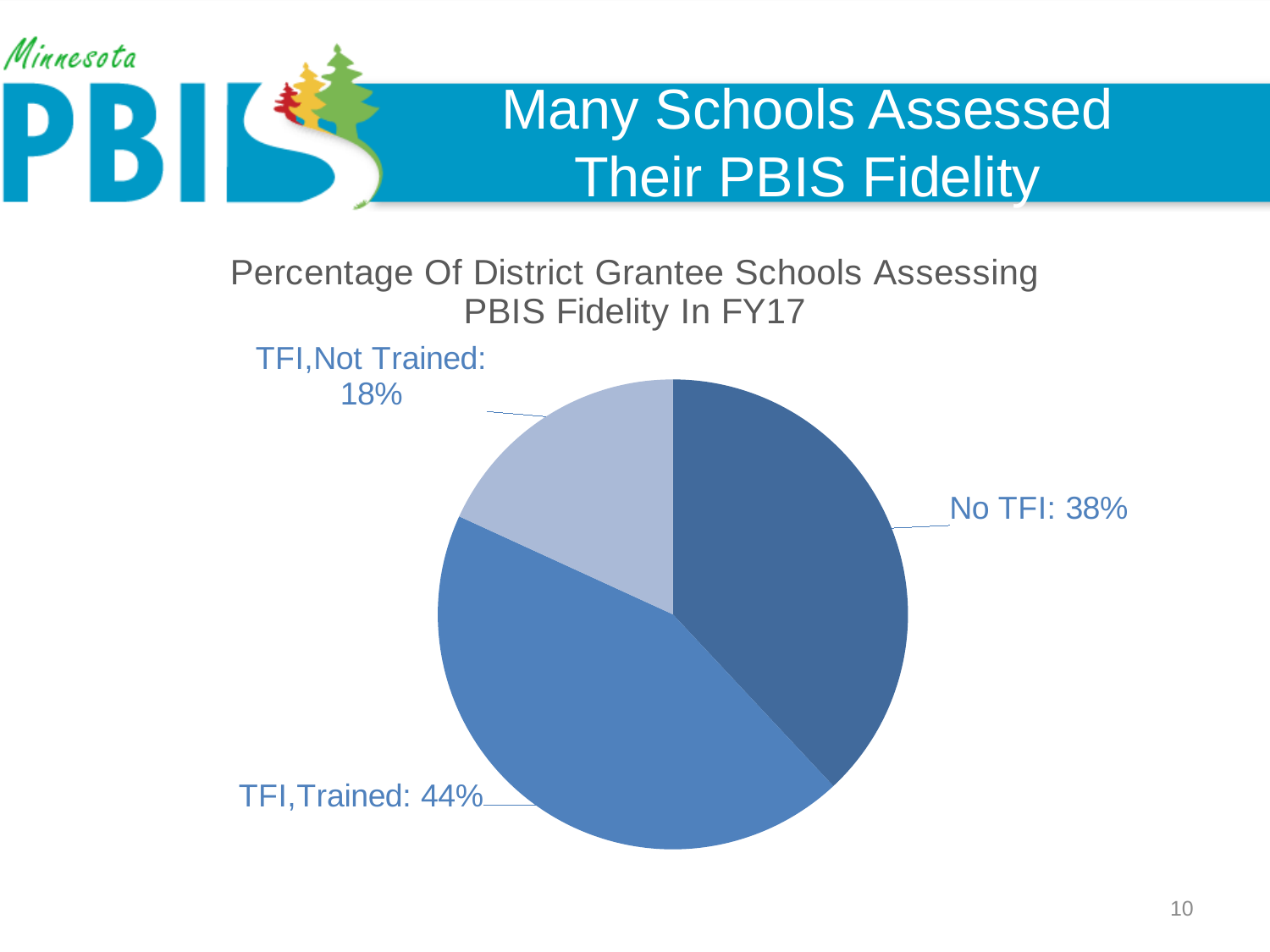
What percentage of schools are in the TFI, Trained category? 44% Which category has the largest share of the pie? TFI, Trained How many slices does the pie chart have? 3 What is the combined share of the two TFI categories (Trained and Not Trained)? 62% What percentage of schools are in the TFI, Not Trained category? 18% What is the difference in percentage points between TFI, Trained and No TFI? 6 What type of chart is shown on the slide? pie chart What percentage of schools are in the No TFI category? 38% Which category has the smallest share of the pie? TFI, Not Trained Which is larger, the share for No TFI or the share for TFI, Not Trained? No TFI What is the chart's title? Percentage Of District Grantee Schools Assessing PBIS Fidelity In FY17 What is the difference in percentage points between No TFI and TFI, Not Trained? 20